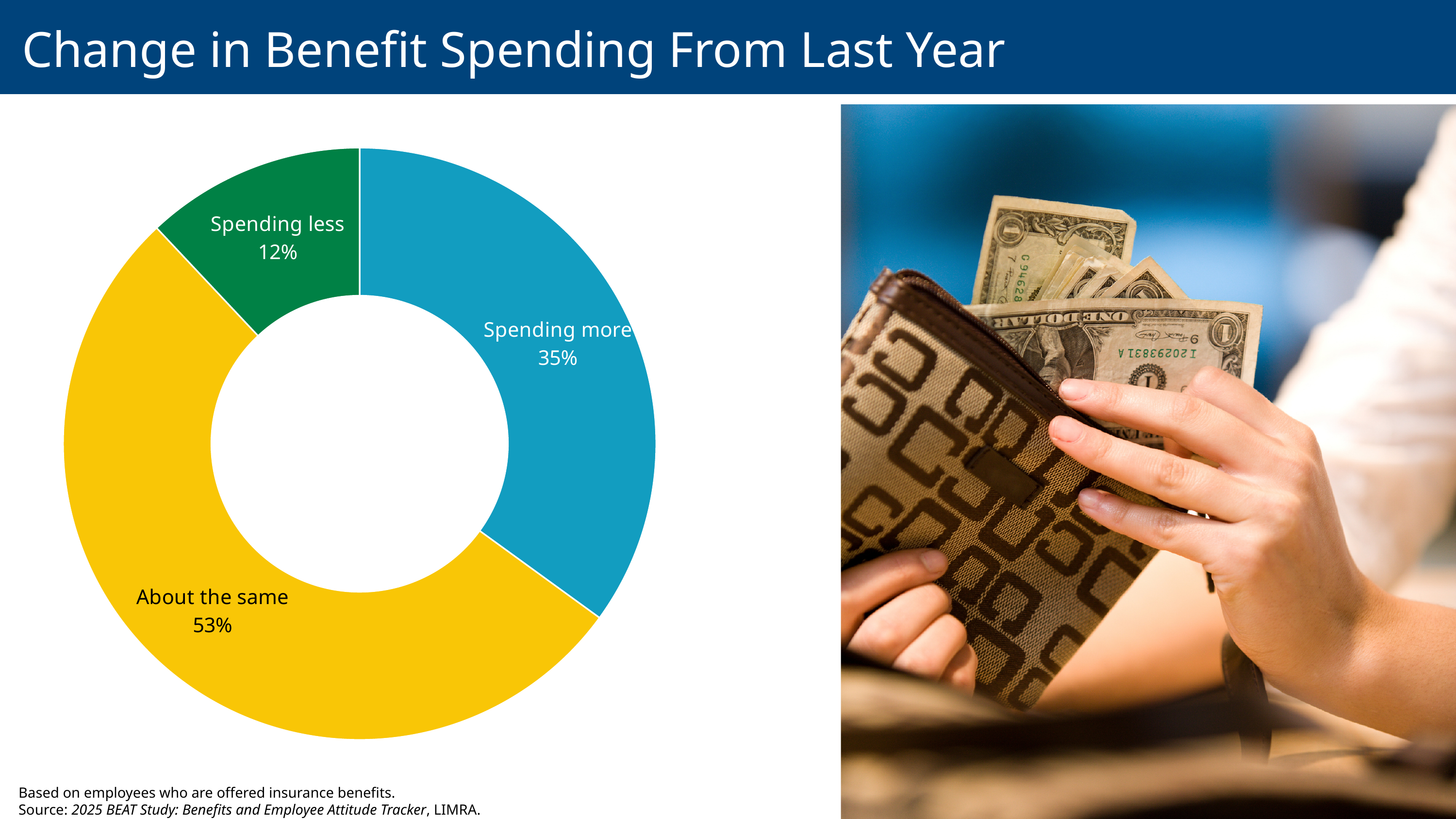
Which is larger, the share for 'Spending more' or the share for 'Spending less'? Spending more What is the difference in percentage points between 'Spending more' and 'Spending less'? 23 What is the title of the slide? Change in Benefit Spending From Last Year What is the difference in percentage points between 'About the same' and 'Spending more'? 18 What colour is the 'About the same' segment of the chart? Yellow What kind of chart is shown on the slide? Doughnut (pie) chart Which category has the smallest share of the chart? Spending less What percentage of employees are spending less on benefits than last year? 12% What percentage of employees are spending about the same on benefits as last year? 53% Which category has the largest share of the chart? About the same What percentage of employees are spending more on benefits than last year? 35% How many categories are shown in the chart? 3